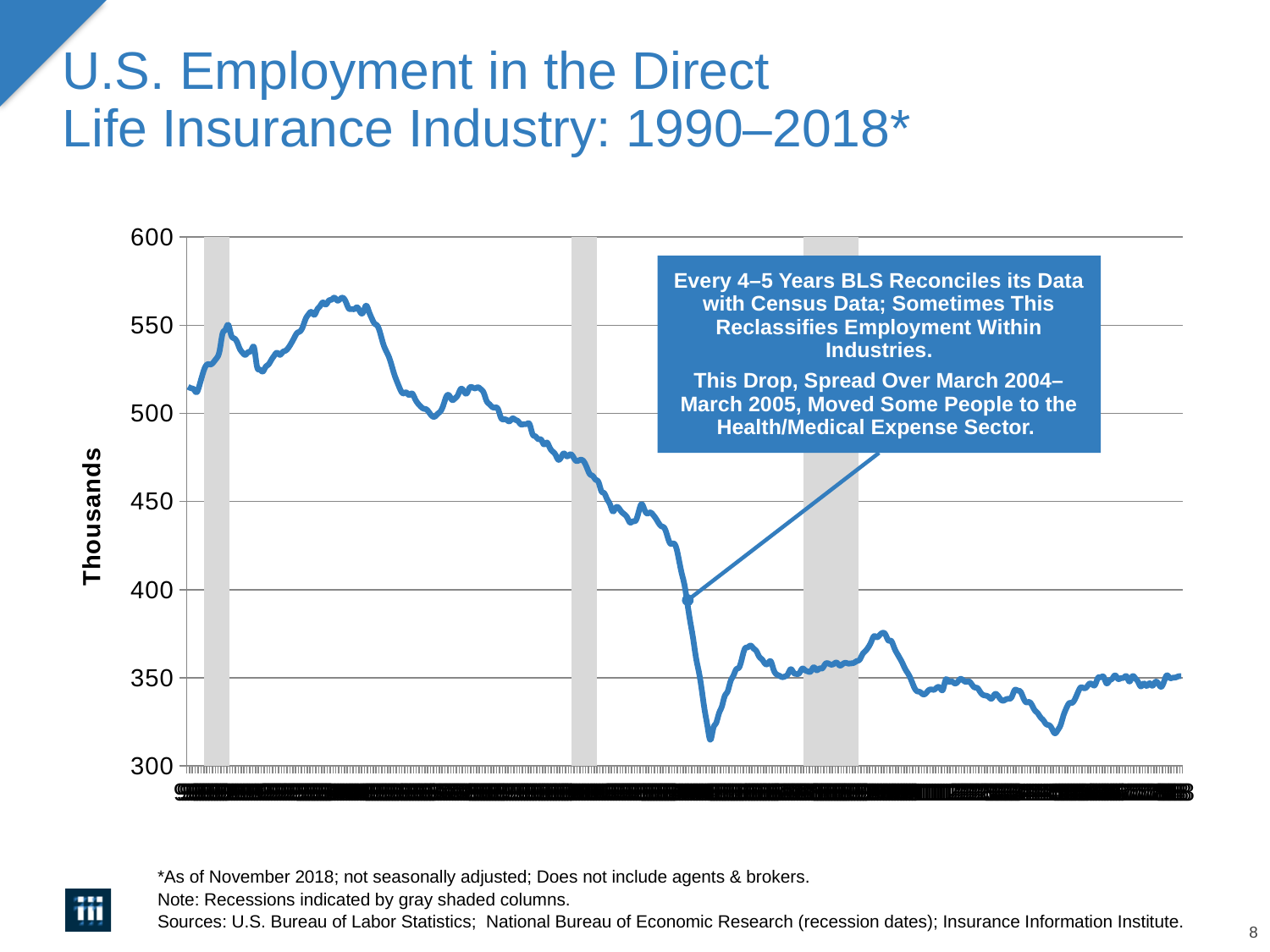
How many gray shaded recession columns appear on the chart? 3 Is the value at the end of the series (November 2018) greater or less than the value at the start (1990)? less Is the highest point of the line greater or less than 550? greater According to the note on the slide, what do the gray shaded columns on the chart indicate? Recessions What kind of chart is shown on the slide? line chart Overall, does employment in the direct life insurance industry rise or fall from the left of the chart (1990) to the right (2018)? fall Is the value at the start of the series (1990) greater or less than 500? greater Is the value at the end of the series (November 2018) greater or less than 400? less What is the label on the vertical axis of the chart? Thousands